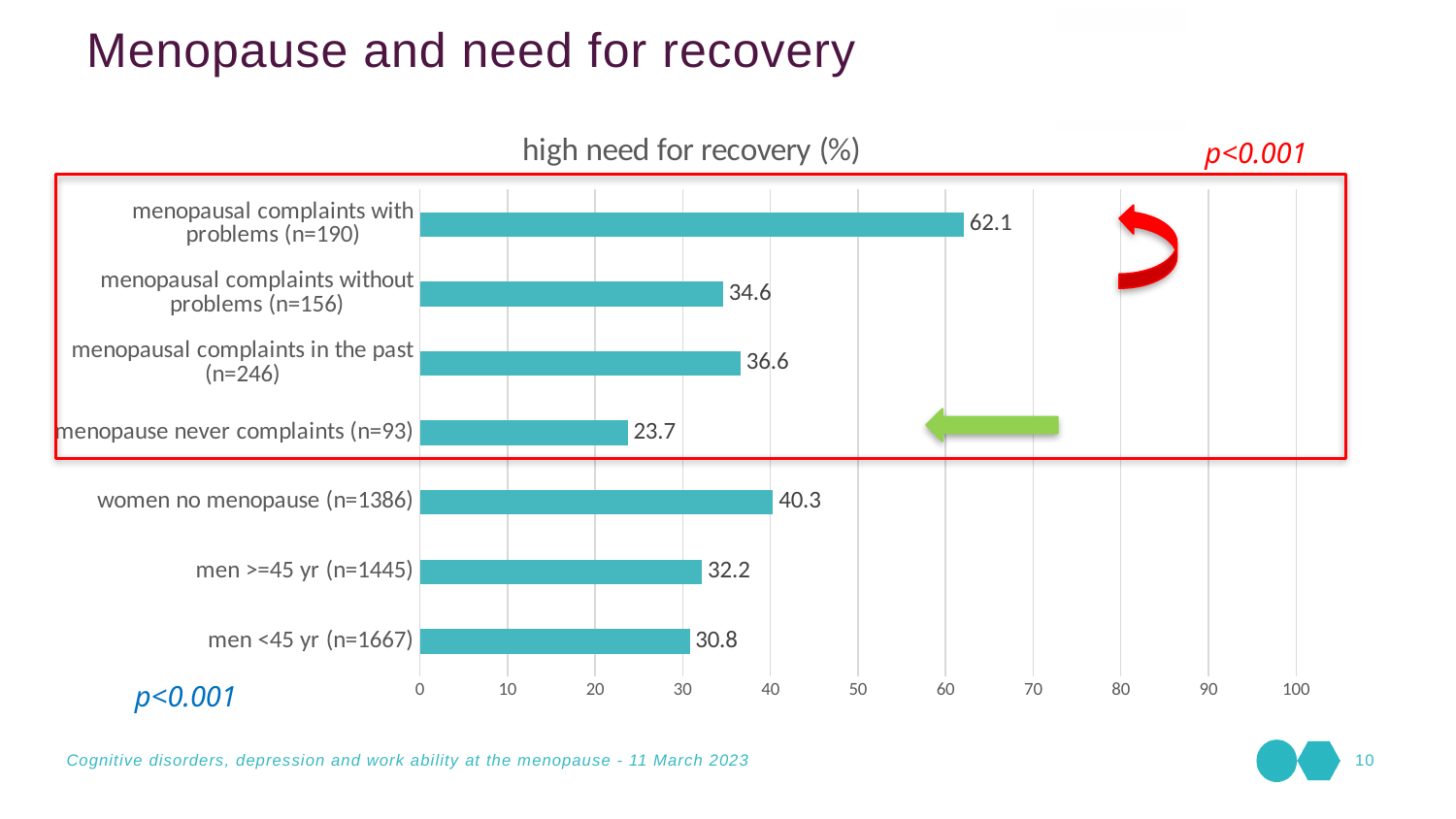
Which category has the lowest high need for recovery (%)? menopause never complaints (n=93) Is the value for menopausal complaints in the past (n=246) greater or less than 30? greater What is the difference between the values for menopausal complaints in the past (n=246) and menopausal complaints without problems (n=156)? 2.0 What is the value for women no menopause (n=1386)? 40.3 Which is larger: the value for men >=45 yr (n=1445) or men <45 yr (n=1667)? men >=45 yr (n=1445) What kind of chart is shown on the slide? bar chart What is the value for menopausal complaints with problems (n=190)? 62.1 How many categories are shown in the chart? 7 What is the value for men <45 yr (n=1667)? 30.8 What is the difference between the values for menopausal complaints with problems (n=190) and menopause never complaints (n=93)? 38.4 What is the title of the chart? high need for recovery (%) Which category has the highest high need for recovery (%)? menopausal complaints with problems (n=190)